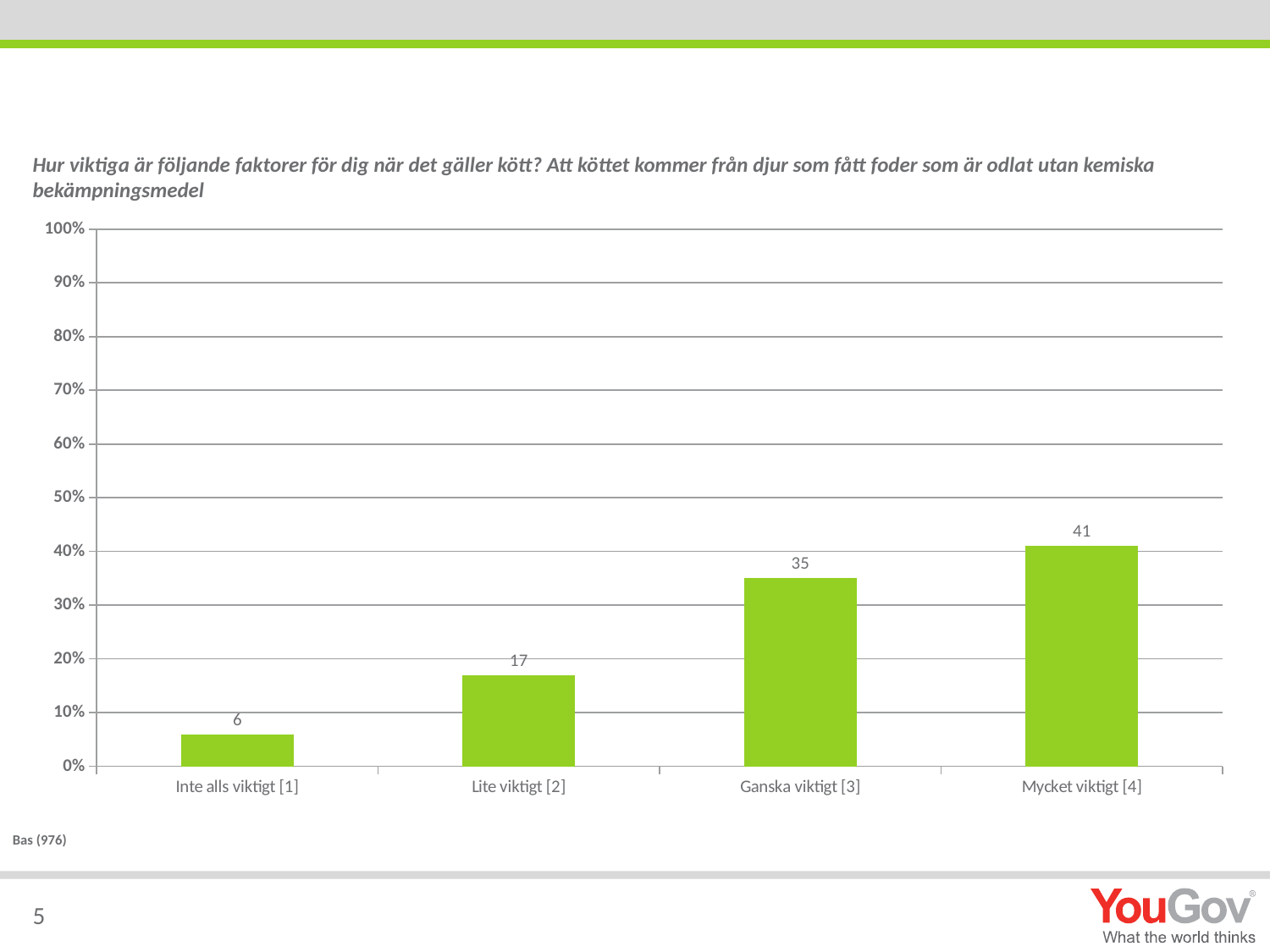
What is the value for "Inte alls viktigt [1]"? 6 What is the value for "Mycket viktigt [4]"? 41 What is the difference between the values for "Mycket viktigt [4]" and "Ganska viktigt [3]"? 6 Do the values rise or fall from left to right along the x axis? rise Which is larger, the value for "Lite viktigt [2]" or the value for "Ganska viktigt [3]"? Ganska viktigt [3] Which category has the lowest value? Inte alls viktigt [1] What is the value for "Lite viktigt [2]"? 17 How many categories are shown on the x axis? 4 Is the value for "Ganska viktigt [3]" greater or less than 30%? greater What kind of chart is shown on the slide? bar chart What is the value for "Ganska viktigt [3]"? 35 Which category has the highest value? Mycket viktigt [4]